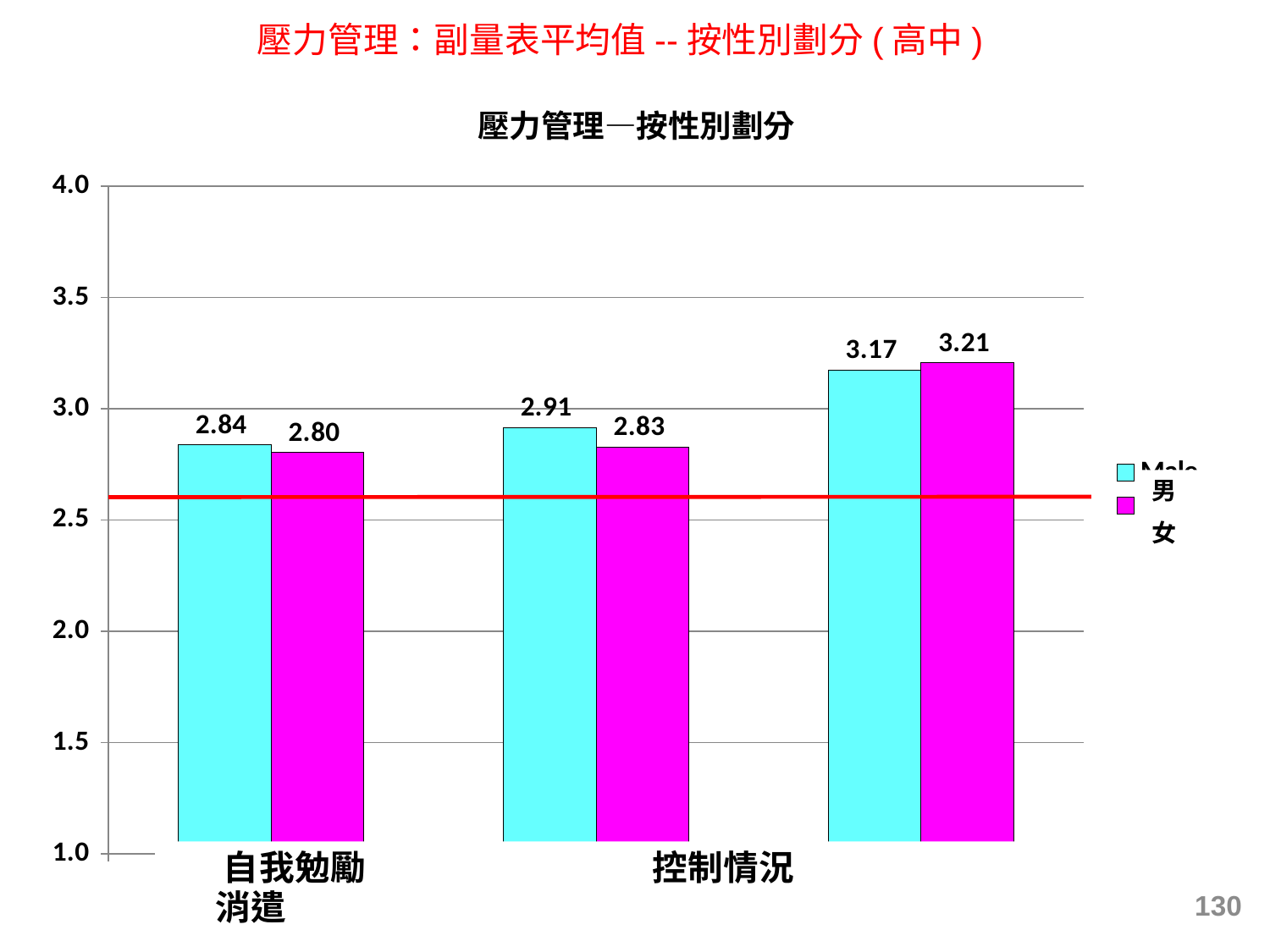
What is the value for 男 in the 自我勉勵 category? 2.84 What is the value for 女 in the 自我勉勵 category? 2.80 What is the difference between the 男 and 女 values in the 控制情況 category? 0.08 Which series has the highest value in the rightmost group of bars? 女 How many groups of bars are shown in the chart? 3 In the 自我勉勵 category, which series has the larger value, 男 or 女? 男 What is the title of the chart? 壓力管理—按性別劃分 What is the value for 女 in the 控制情況 category? 2.83 What kind of chart is shown on the slide? bar chart What is the value for 男 in the rightmost group of bars? 3.17 How many series does the legend list? 2 Is the value for 男 in the 控制情況 category greater or less than 3.0? less